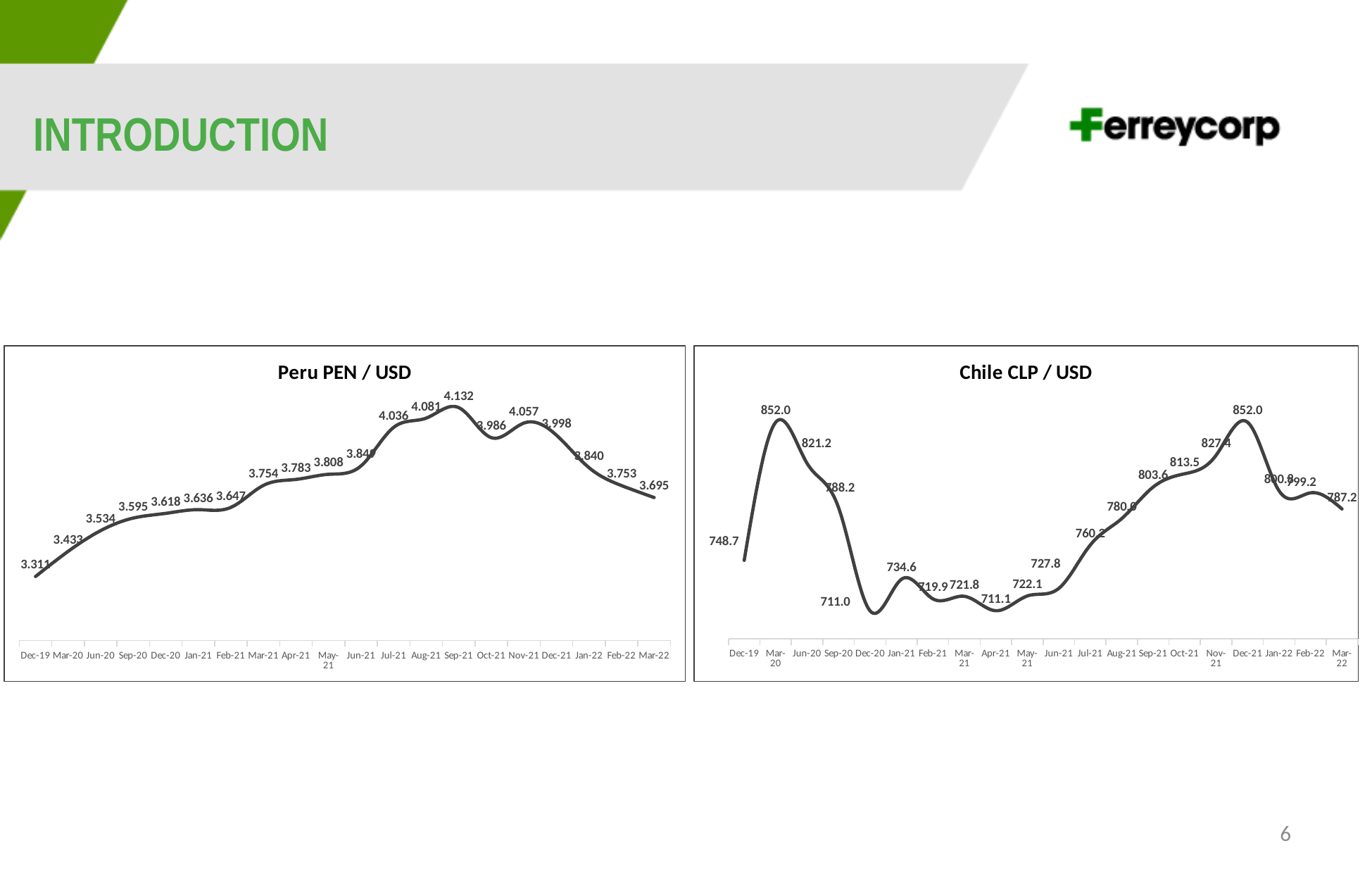
In the Chile CLP / USD chart, what is the value for Mar-22? 787.2 What type of chart is the Chile CLP / USD chart? Line chart In the Peru PEN / USD chart, what is the difference between the Mar-22 value and the Dec-19 value? 0.384 In the Chile CLP / USD chart, which is larger, the value for Mar-20 or the value for Jun-20? Mar-20 In the Peru PEN / USD chart, which is larger, the value for Oct-21 or the value for Nov-21? Nov-21 How many data points are plotted in the Peru PEN / USD chart? 20 In the Chile CLP / USD chart, what is the value for Jul-21? 760.2 In the Peru PEN / USD chart, what is the value for Sep-21? 4.132 In the Chile CLP / USD chart, what is the difference between the Dec-21 value and the Nov-21 value? 24.6 In the Chile CLP / USD chart, what is the value for Dec-20? 711.0 In the Peru PEN / USD chart, which month has the highest value? Sep-21 In the Peru PEN / USD chart, which month has the lowest value? Dec-19